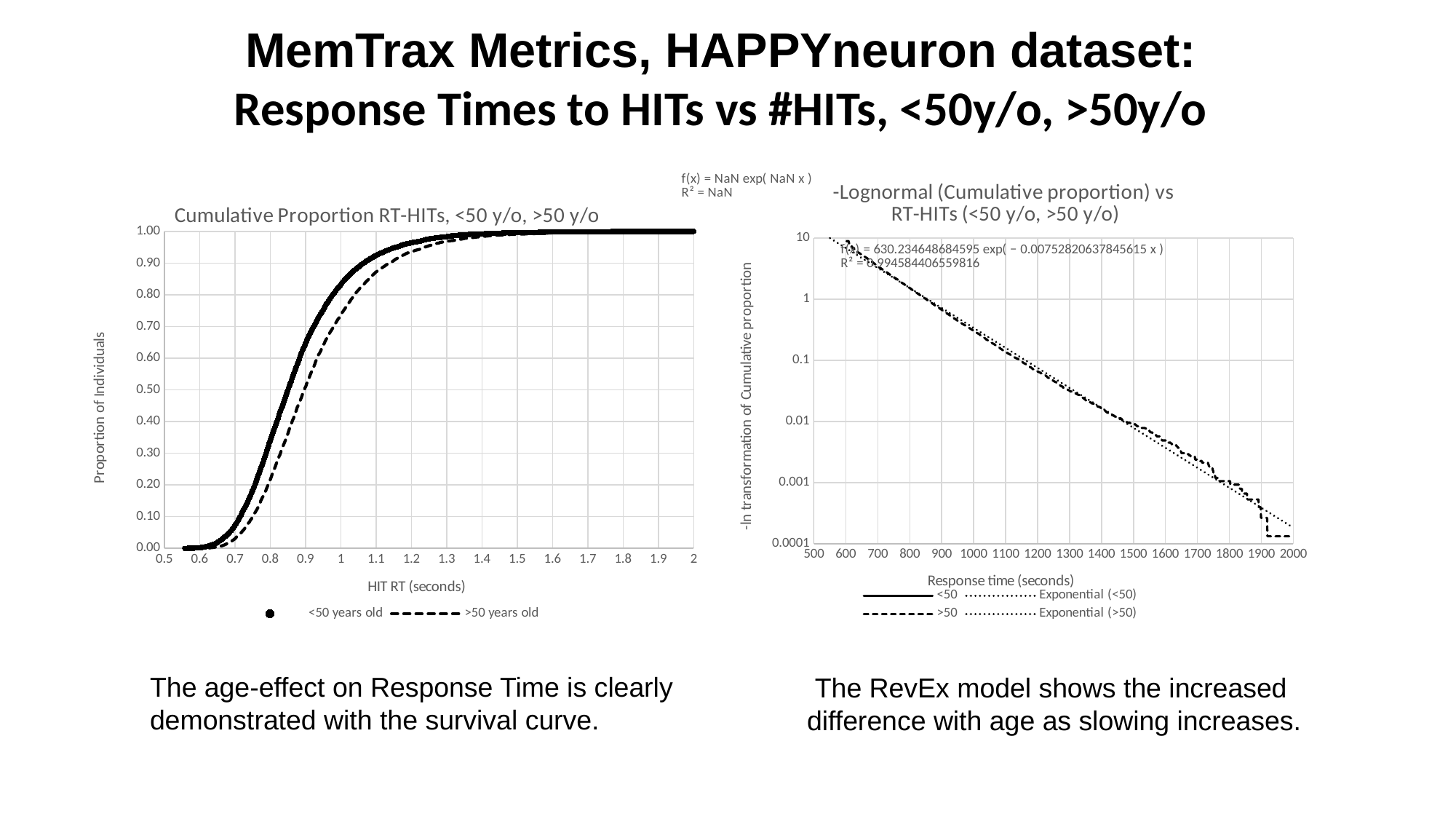
In the left chart, is the value for <50 years old at a HIT RT of 1.2 seconds greater or less than 0.90? greater What is the title of the chart on the left? Cumulative Proportion RT-HITs, <50 y/o, >50 y/o In the left chart, is the value for >50 years old at a HIT RT of 1.0 seconds greater or less than 0.50? greater What kind of chart is the chart on the left? line chart In the left chart, is the value for >50 years old at a HIT RT of 0.7 seconds greater or less than 0.10? less In the left chart, do the values rise or fall as HIT RT increases? rise What is the x-axis label of the right chart? Response time (seconds) How many series does the legend of the left chart list? 2 In the right chart, do the plotted values rise or fall as response time increases? fall In the left chart, at a HIT RT of 0.9 seconds, which series has the higher cumulative proportion, <50 years old or >50 years old? <50 years old How many entries does the legend of the right chart list? 4